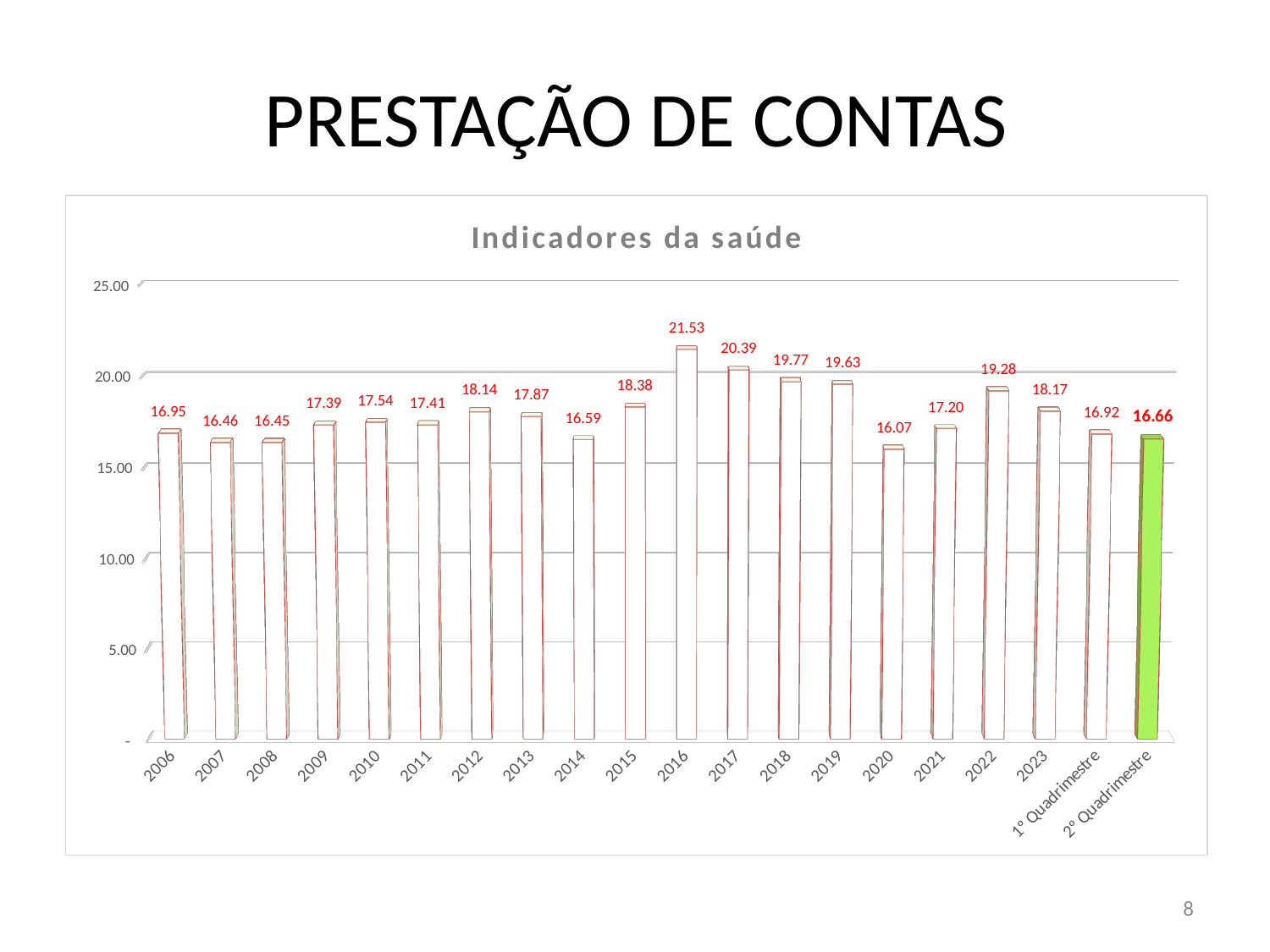
Do the values in the Indicadores da saúde chart rise or fall from 2016 to 2020? fall What is the value for 2016 in the Indicadores da saúde chart? 21.53 What is the difference between the values for 2016 and 2017 in the Indicadores da saúde chart? 1.14 Which category has the lowest value in the Indicadores da saúde chart? 2020 What kind of chart is the Indicadores da saúde chart? bar chart How many bars are plotted in the Indicadores da saúde chart? 20 What is the value for 2° Quadrimestre in the Indicadores da saúde chart? 16.66 Which bar in the Indicadores da saúde chart is coloured green? 2° Quadrimestre Is the value for 2016 in the Indicadores da saúde chart greater or less than 20.00? greater Which category has the highest value in the Indicadores da saúde chart? 2016 Which is larger in the Indicadores da saúde chart, the value for 2012 or the value for 2014? 2012 What is the value for 2020 in the Indicadores da saúde chart? 16.07